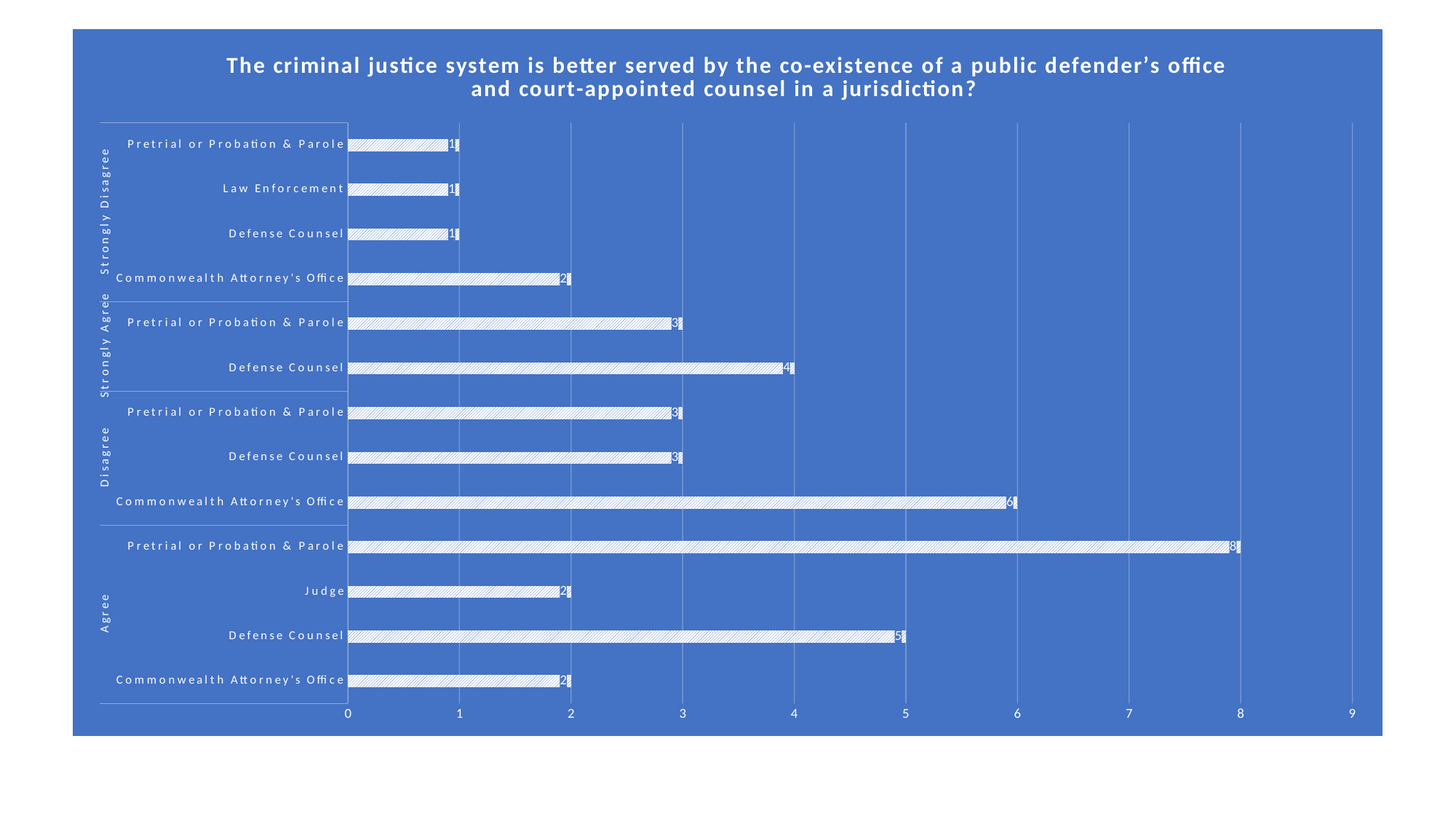
What is the value for Commonwealth Attorney's Office in the Disagree group? 6 What kind of chart is shown on the slide? Bar chart What is the value for Judge in the Agree group? 2 What is the total of the values in the Strongly Disagree group? 5 Which bar has the highest value on the chart? Pretrial or Probation & Parole (Agree) What is the difference between Defense Counsel in the Agree group and Defense Counsel in the Strongly Agree group? 1 How many bars are plotted on the chart? 13 What is the highest value shown on the horizontal axis? 9 What is the value for Defense Counsel in the Strongly Agree group? 4 How many response groups are labelled on the vertical axis? 4 What is the value for Pretrial or Probation & Parole in the Agree group? 8 Which is larger: Commonwealth Attorney's Office in the Disagree group or Defense Counsel in the Agree group? Commonwealth Attorney's Office (Disagree)